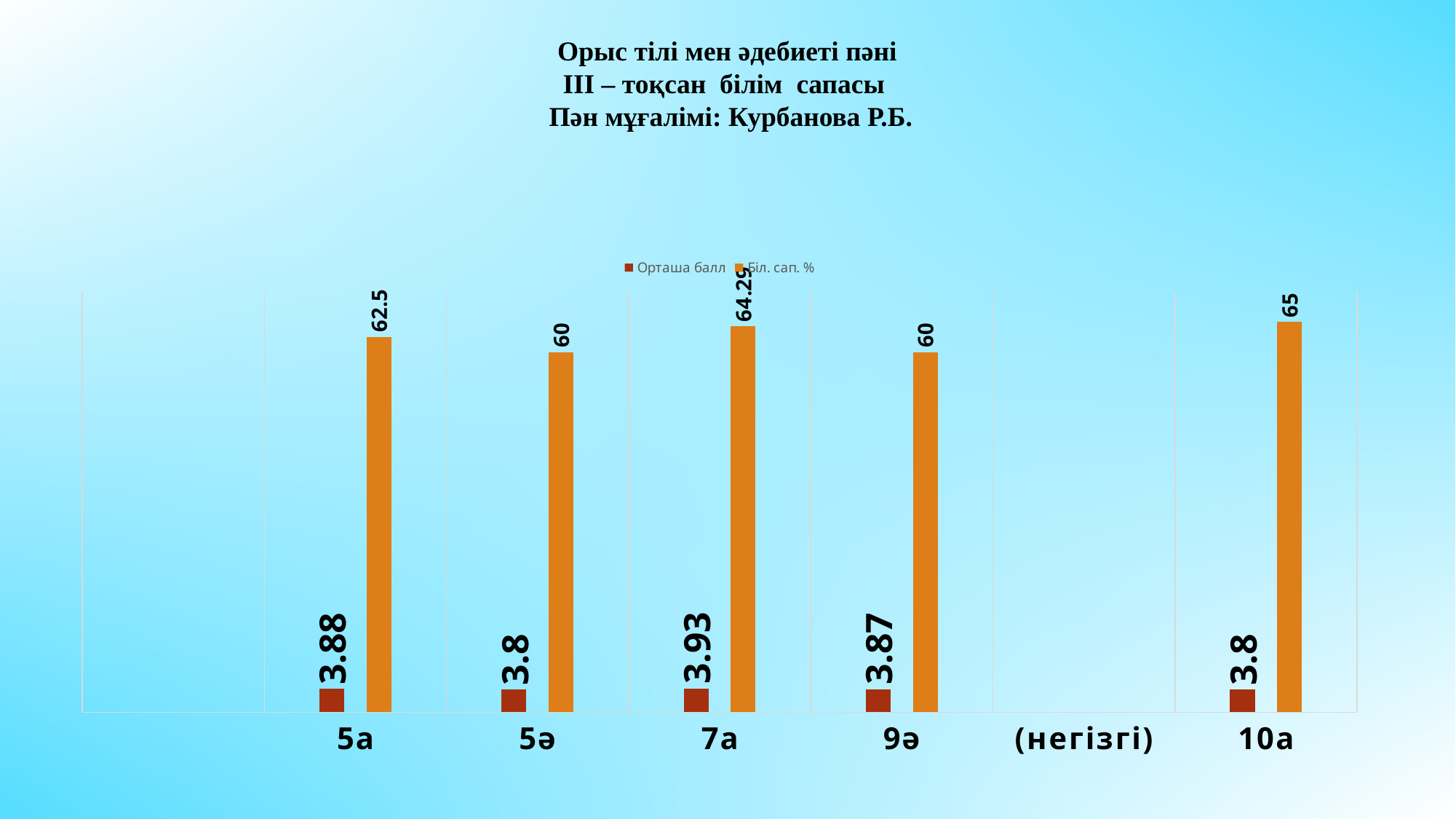
Which series is shown in orange in the legend? Біл. сап. % How many categories on the x axis have bars plotted? 5 How many series does the legend list? 2 Which is larger, the Біл. сап. % value for 7а or for 9ә? 7а Which category has the highest Біл. сап. % value? 10а What kind of chart is shown on the slide? bar chart What is the Орташа балл value for 5а? 3.88 Which category has the highest Орташа балл value? 7а What is the Орташа балл value for 9ә? 3.87 What is the Біл. сап. % value for 10а? 65 What is the difference between the Біл. сап. % values for 10а and 5а? 2.5 What is the Біл. сап. % value for 7а? 64.29